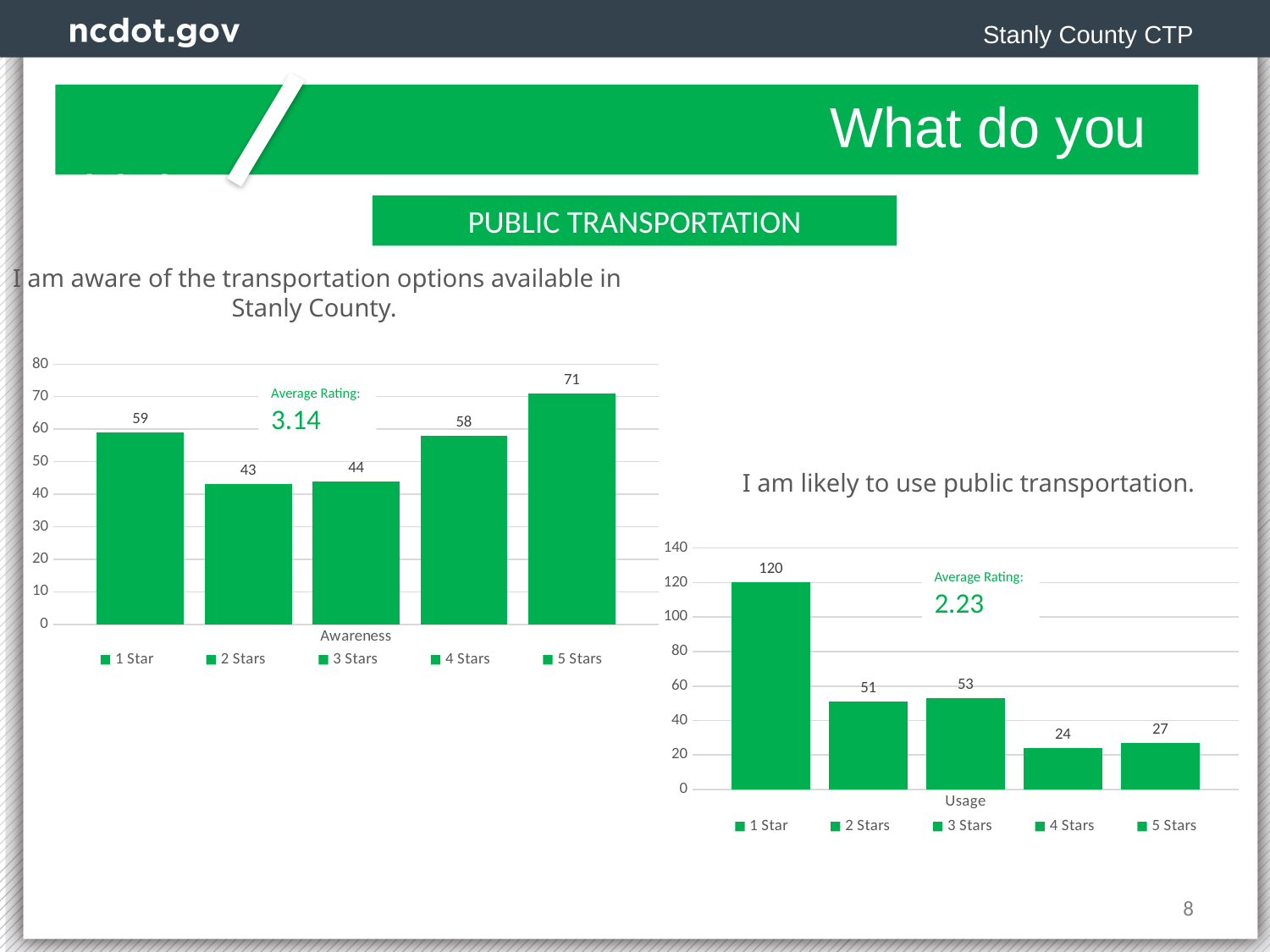
In the Usage chart (right), is the value for 3 Stars greater or less than 60? less In the Usage chart (right), what is the value for 1 Star? 120 What average rating is shown on the Usage chart (right)? 2.23 In the Awareness chart (left), what is the difference between the 5 Stars value and the 1 Star value? 12 In the Usage chart (right), which rating has the lowest value? 4 Stars How many series does the legend of the Usage chart (right) list? 5 In the Awareness chart (left), which is larger, the value for 1 Star or the value for 4 Stars? 1 Star In the Awareness chart (left), which rating has the lowest value? 2 Stars In the Usage chart (right), what is the difference between the 1 Star value and the 2 Stars value? 69 In the Awareness chart (left), what is the value for 5 Stars? 71 In the Usage chart (right), which rating has the highest value? 1 Star What kind of chart is the Awareness chart (left)? bar chart